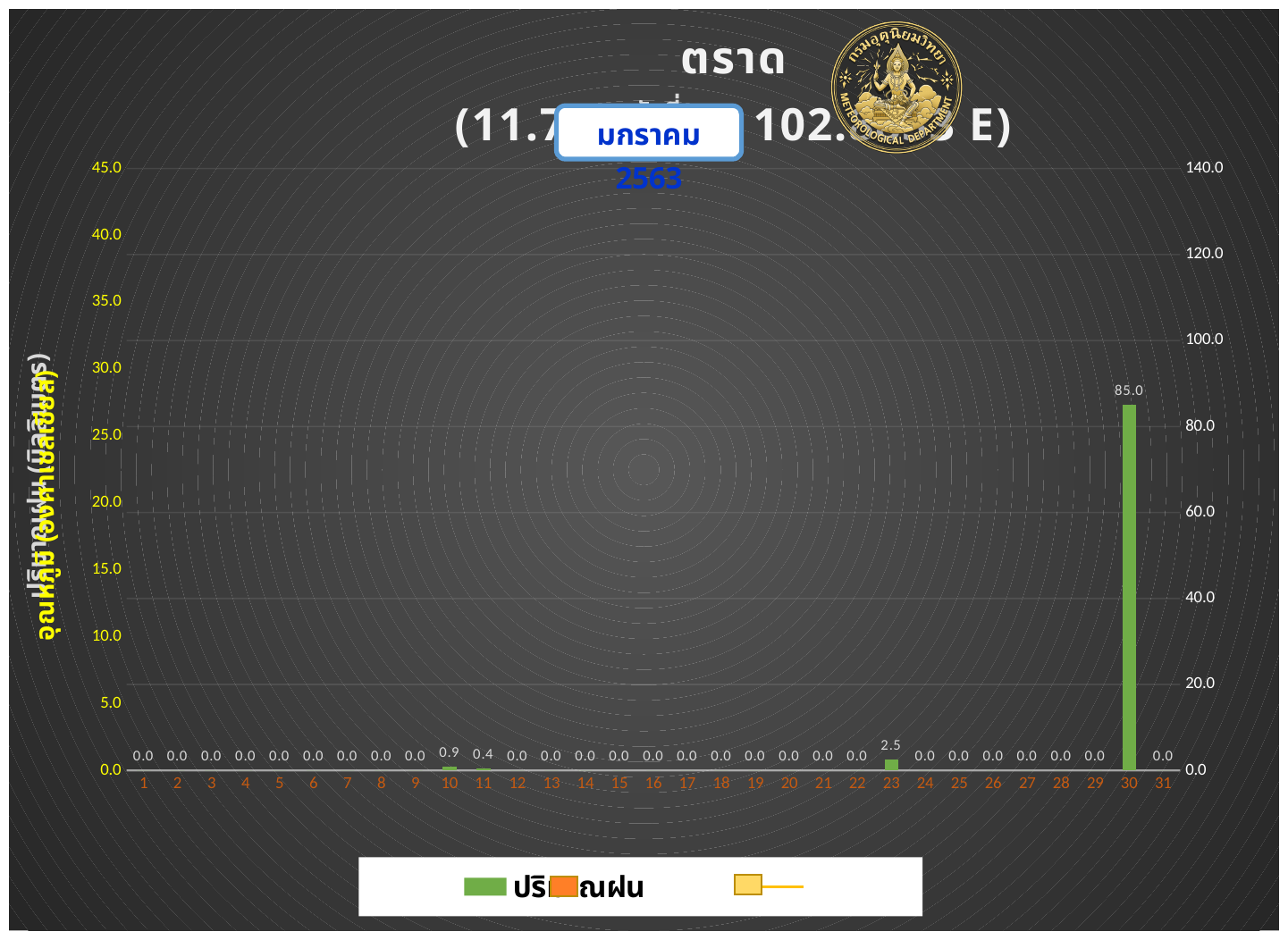
Which is larger, the rainfall value for day 10 or for day 23? day 23 How many days are shown on the x axis? 31 Which day has the highest rainfall value? 30 What is the rainfall value shown for day 10? 0.9 What is the rainfall value shown for day 30? 85.0 What is the rainfall value shown for day 31? 0.0 What is the rainfall value shown for day 11? 0.4 What is the difference between the rainfall values for day 10 and day 11? 0.5 What is the difference between the rainfall values for day 30 and day 23? 82.5 What kind of chart is shown on the slide? bar chart Is the rainfall value for day 30 greater or less than 80.0 on the right axis? greater What is the rainfall value shown for day 23? 2.5